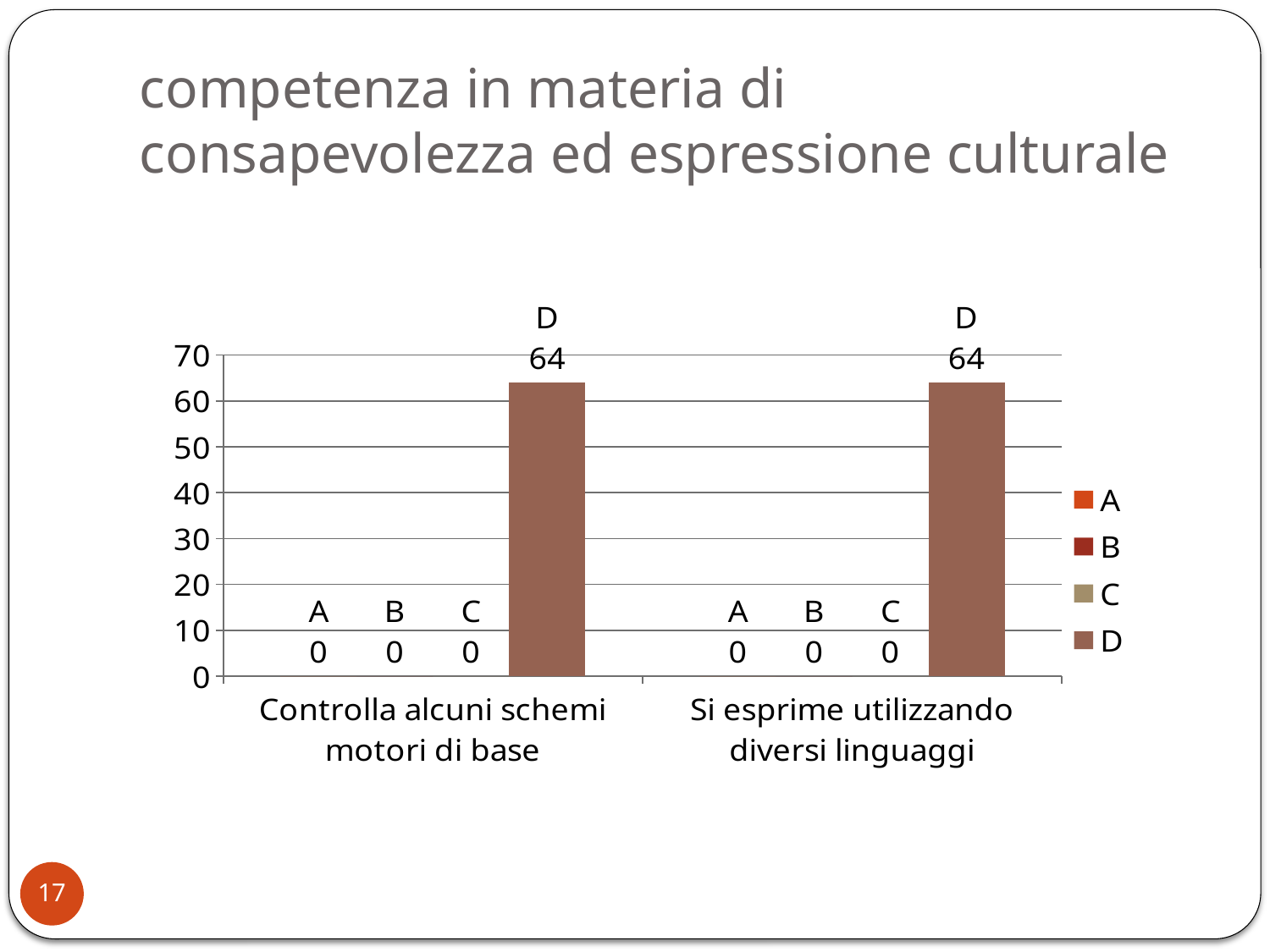
What is the value of series D for "Controlla alcuni schemi motori di base"? 64 What is the value of series D for "Si esprime utilizzando diversi linguaggi"? 64 What is the value of series A for "Controlla alcuni schemi motori di base"? 0 How many categories are shown on the x axis? 2 Is the value of series D for "Controlla alcuni schemi motori di base" greater or less than 60? greater What is the highest value shown on the vertical axis? 70 What is the total of series A, B, C and D for "Si esprime utilizzando diversi linguaggi"? 64 What is the difference between series D and series B for "Controlla alcuni schemi motori di base"? 64 Which series has the highest value for "Si esprime utilizzando diversi linguaggi"? D What is the value of series C for "Si esprime utilizzando diversi linguaggi"? 0 What kind of chart is shown on the slide? bar chart How many series does the legend list? 4